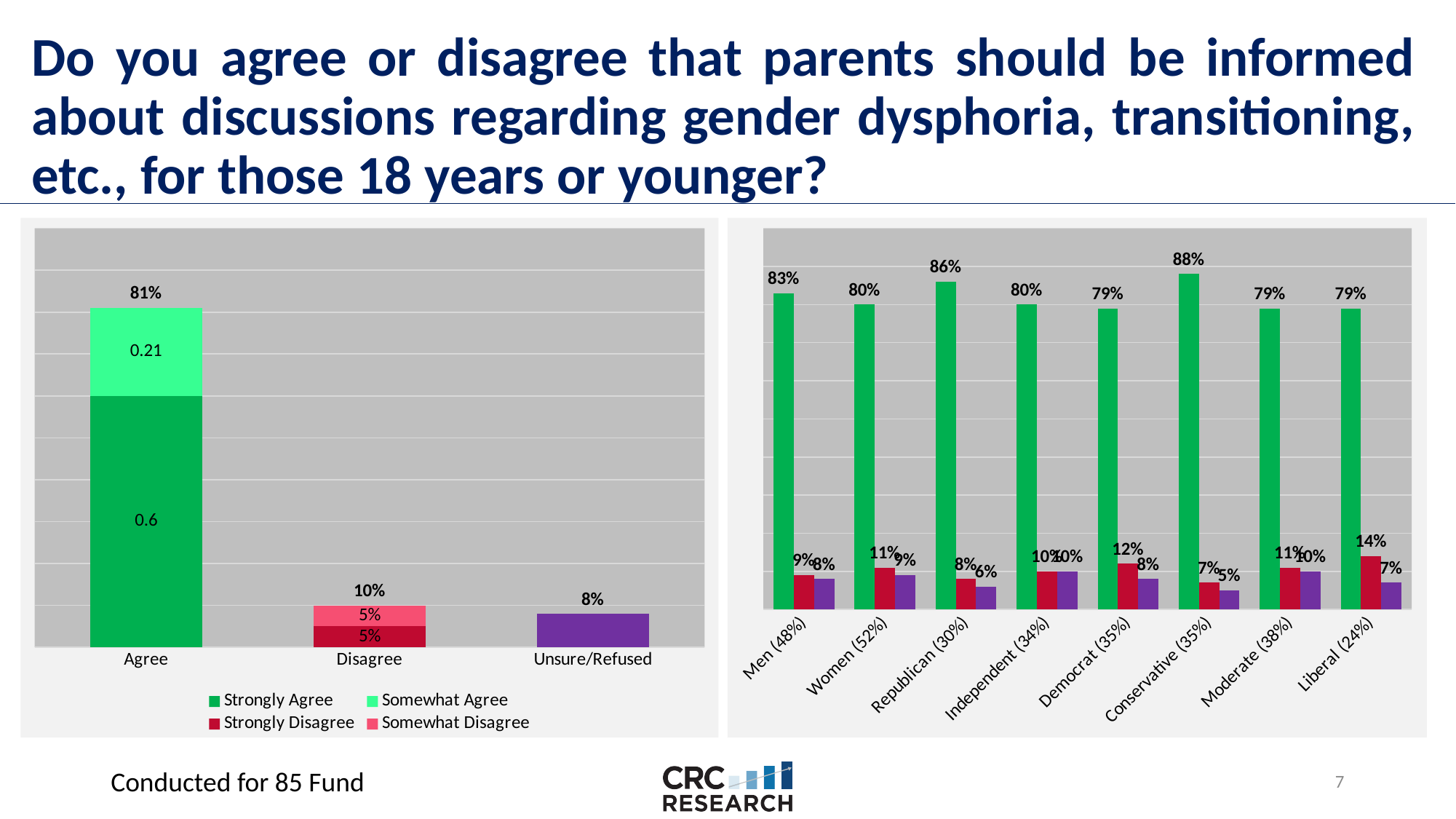
On the left chart, what is the difference between the Agree total and the Disagree total? 71% On the left chart, what is the total value shown for the Agree bar? 81% On the left chart, how many series does the legend list? 4 On the left chart, what is the value for Unsure/Refused? 8% On the right chart, what is the value of the red (disagree) bar for Liberal (24%)? 14% What kind of chart is the left chart? Stacked bar chart On the right chart, how many demographic groups are shown on the x axis? 8 On the right chart, which group has the highest green (agree) bar? Conservative (35%) On the left chart, what value is printed for the Somewhat Agree segment of the Agree bar? 0.21 On the left chart, what value is printed for the Strongly Agree segment of the Agree bar? 0.6 On the right chart, which is larger: the green (agree) bar for Men (48%) or for Women (52%)? Men (48%) On the right chart, what is the value of the green (agree) bar for Republican (30%)? 86%